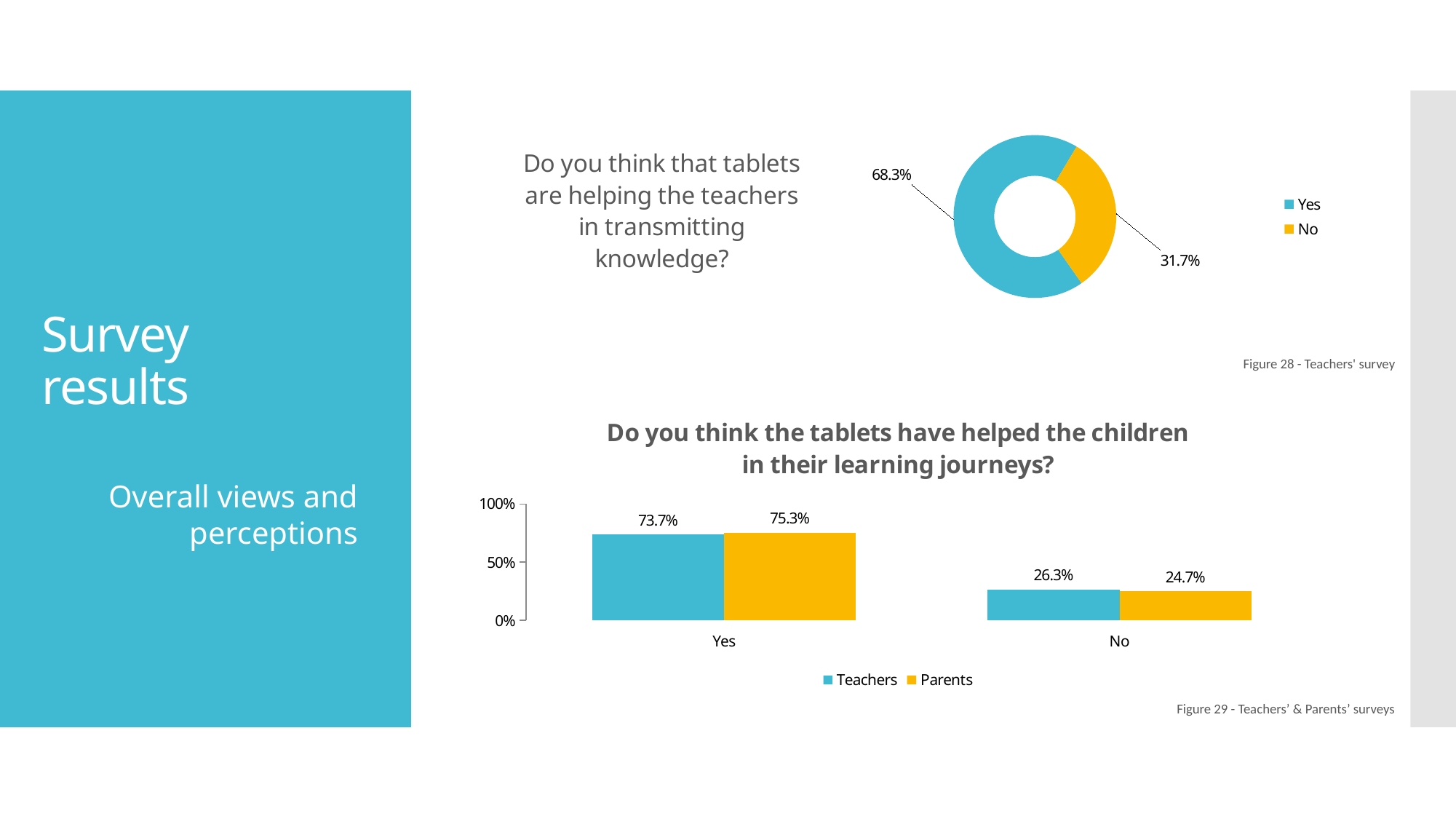
What kind of chart is the bottom chart (Figure 29 - Teachers' & Parents' surveys)? Bar chart In the bottom chart (Figure 29), which colour represents Parents? Yellow In the bottom chart (Do you think the tablets have helped the children in their learning journeys?), what is the value for Parents answering No? 24.7% In the bottom chart (Do you think the tablets have helped the children in their learning journeys?), what is the value for Teachers answering Yes? 73.7% In the top chart (Figure 28), which response has the larger share, Yes or No? Yes In the top chart (Do you think that tablets are helping the teachers in transmitting knowledge?), what percentage answered Yes? 68.3% In the bottom chart (Figure 29), what is the difference between the Parents and Teachers values for Yes? 1.6% In the bottom chart (Figure 29), which is larger for No, Teachers or Parents? Teachers What kind of chart is the top chart (Figure 28 - Teachers' survey)? Doughnut chart In the top chart (Do you think that tablets are helping the teachers in transmitting knowledge?), what percentage answered No? 31.7% In the bottom chart (Figure 29), how many series does the legend list? 2 In the top chart (Figure 28), how many categories does the legend list? 2